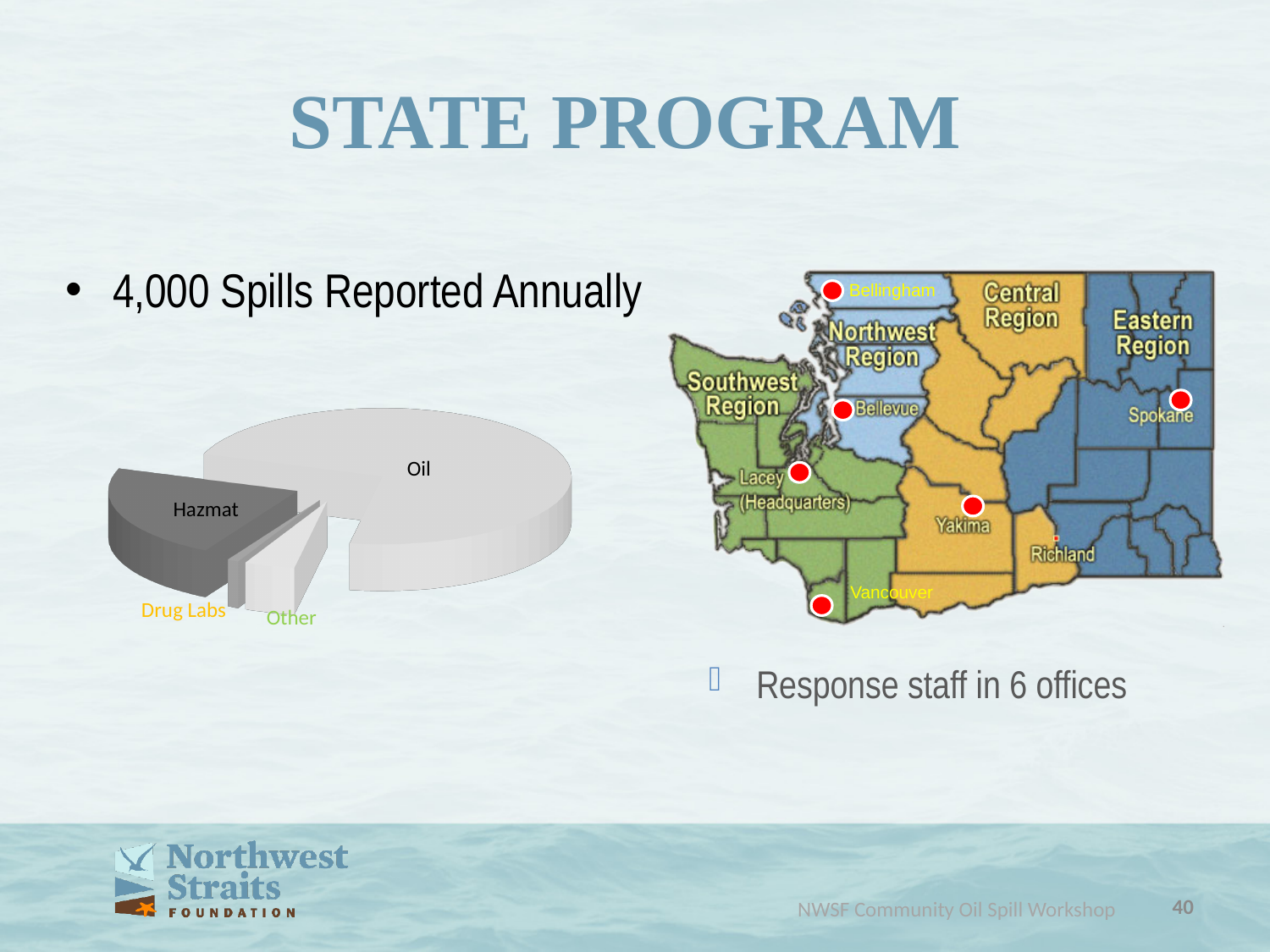
In the pie chart, which slice is larger, Oil or Other? Oil How many slices does the pie chart have? 4 In the pie chart, which slice is larger, Hazmat or Other? Hazmat Which category has the largest slice in the pie chart? Oil In the pie chart, which slice is larger, Oil or Hazmat? Oil What kind of chart is shown on the left of the slide? pie chart What are the four categories labelled on the pie chart? Oil, Hazmat, Drug Labs, Other Which slice of the pie chart is coloured dark grey? Hazmat